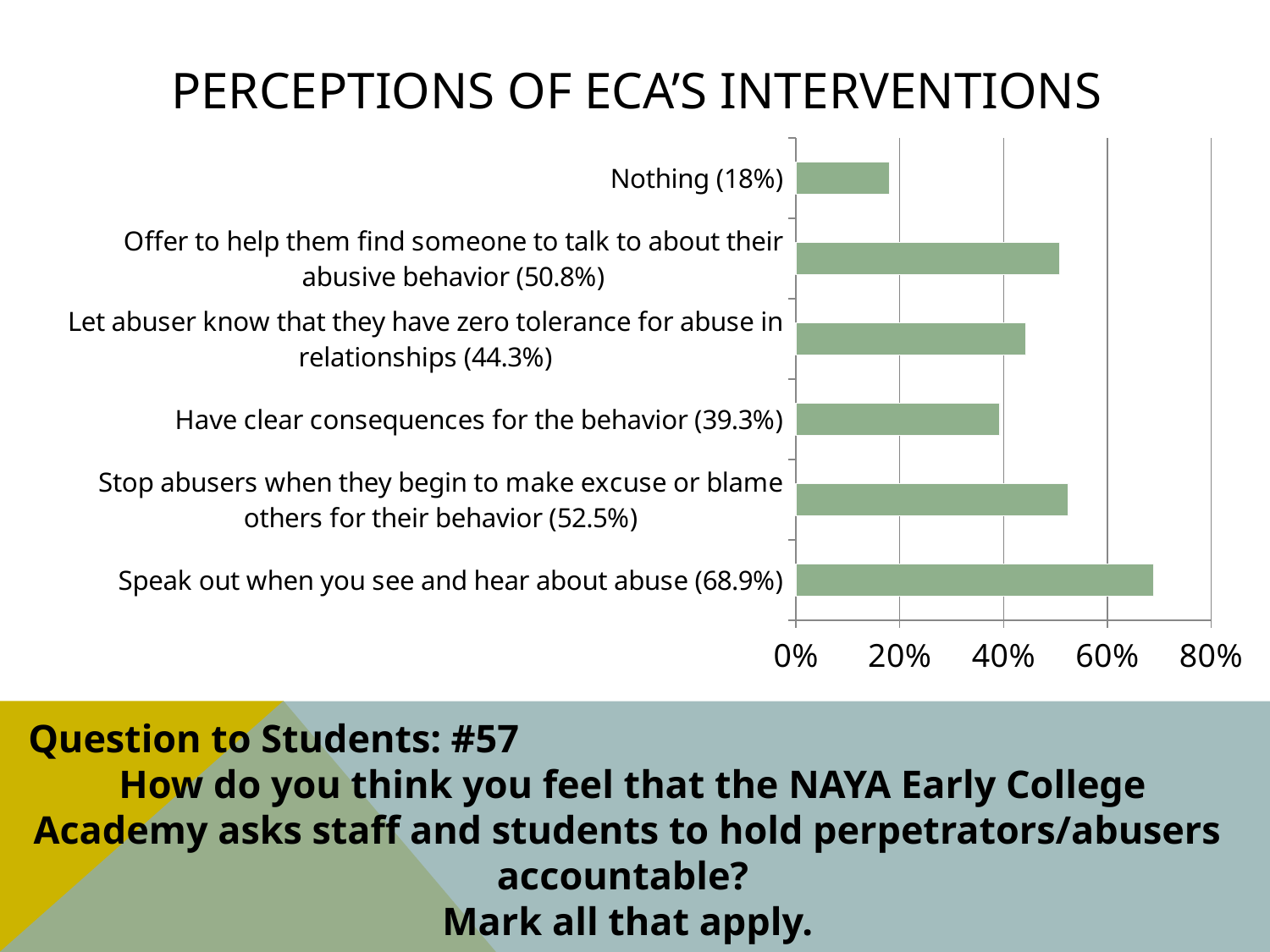
Which category has the lowest percentage? Nothing What percentage of students selected "Nothing"? 18% How many categories are shown in the chart? 6 Is the value for "Speak out when you see and hear about abuse" greater or less than 60%? greater Which intervention has the highest percentage? Speak out when you see and hear about abuse What percentage of students selected "Speak out when you see and hear about abuse"? 68.9% What percentage of students selected "Have clear consequences for the behavior"? 39.3% Which is larger: "Let abuser know that they have zero tolerance for abuse in relationships" or "Have clear consequences for the behavior"? Let abuser know that they have zero tolerance for abuse in relationships What is the difference between "Speak out when you see and hear about abuse" and "Nothing"? 50.9% What is the difference between "Stop abusers when they begin to make excuse or blame others for their behavior" and "Offer to help them find someone to talk to about their abusive behavior"? 1.7% What kind of chart is shown on the slide? Bar chart What is the title of the chart? PERCEPTIONS OF ECA'S INTERVENTIONS